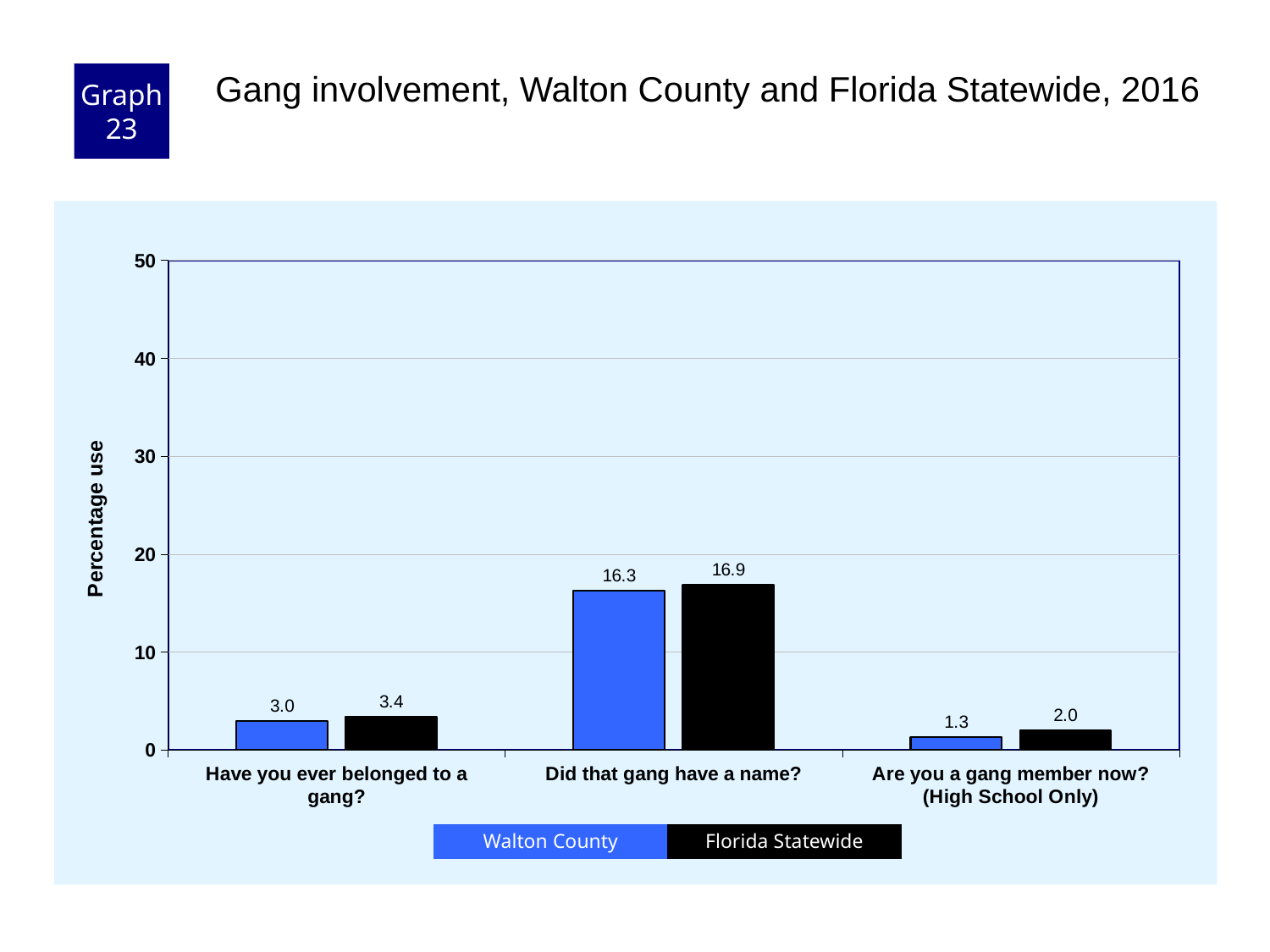
What is the Walton County value for "Did that gang have a name?"? 16.3 How many series does the legend list? 2 What is the label of the y axis? Percentage use Which question category has the highest Florida Statewide value? Did that gang have a name? Is the Florida Statewide value for "Did that gang have a name?" greater or less than 20? less What is the difference between the Florida Statewide and Walton County values for "Did that gang have a name?"? 0.6 Which question category has the lowest Walton County value? Are you a gang member now? (High School Only) How many question categories are shown on the x axis? 3 What is the Walton County value for "Are you a gang member now? (High School Only)"? 1.3 What kind of chart is shown on the slide? Bar chart What is the Florida Statewide value for "Have you ever belonged to a gang?"? 3.4 For "Are you a gang member now? (High School Only)", which is larger: Walton County or Florida Statewide? Florida Statewide